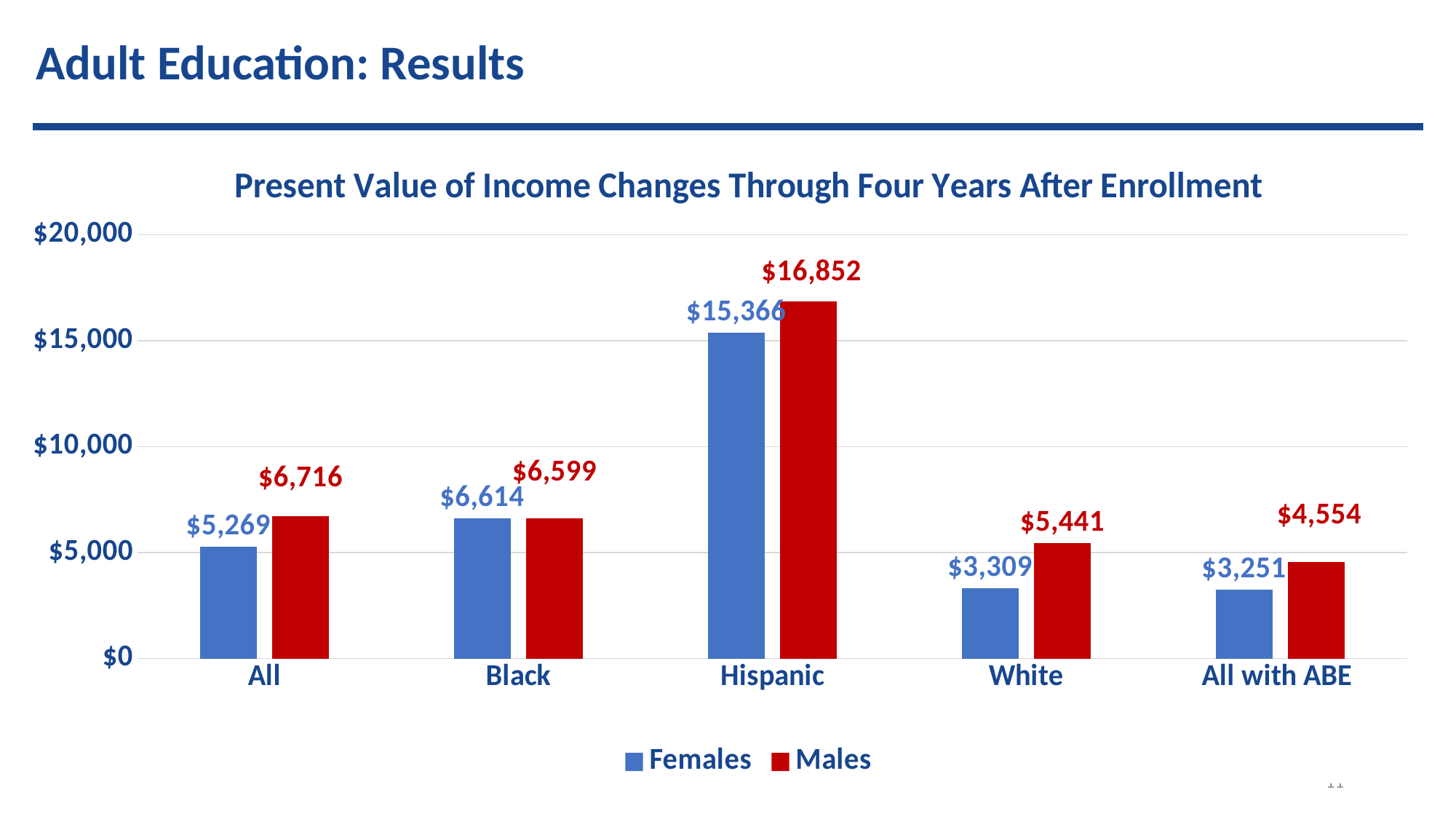
Which category has the highest value for Males? Hispanic What is the value for Females in the Hispanic category? $15,366 What is the difference between the Males and Females values in the Hispanic category? $1,486 What is the difference between the Males and Females values in the White category? $2,132 Which is larger in the All category, the Females value or the Males value? Males What kind of chart is shown on the slide? Bar chart Which category has the lowest value for Females? All with ABE How many categories are shown on the x axis? 5 What is the value for Males in the White category? $5,441 Is the value for Females in the Black category greater or less than $5,000? greater How many series does the legend list? 2 What is the value for Males in the All with ABE category? $4,554